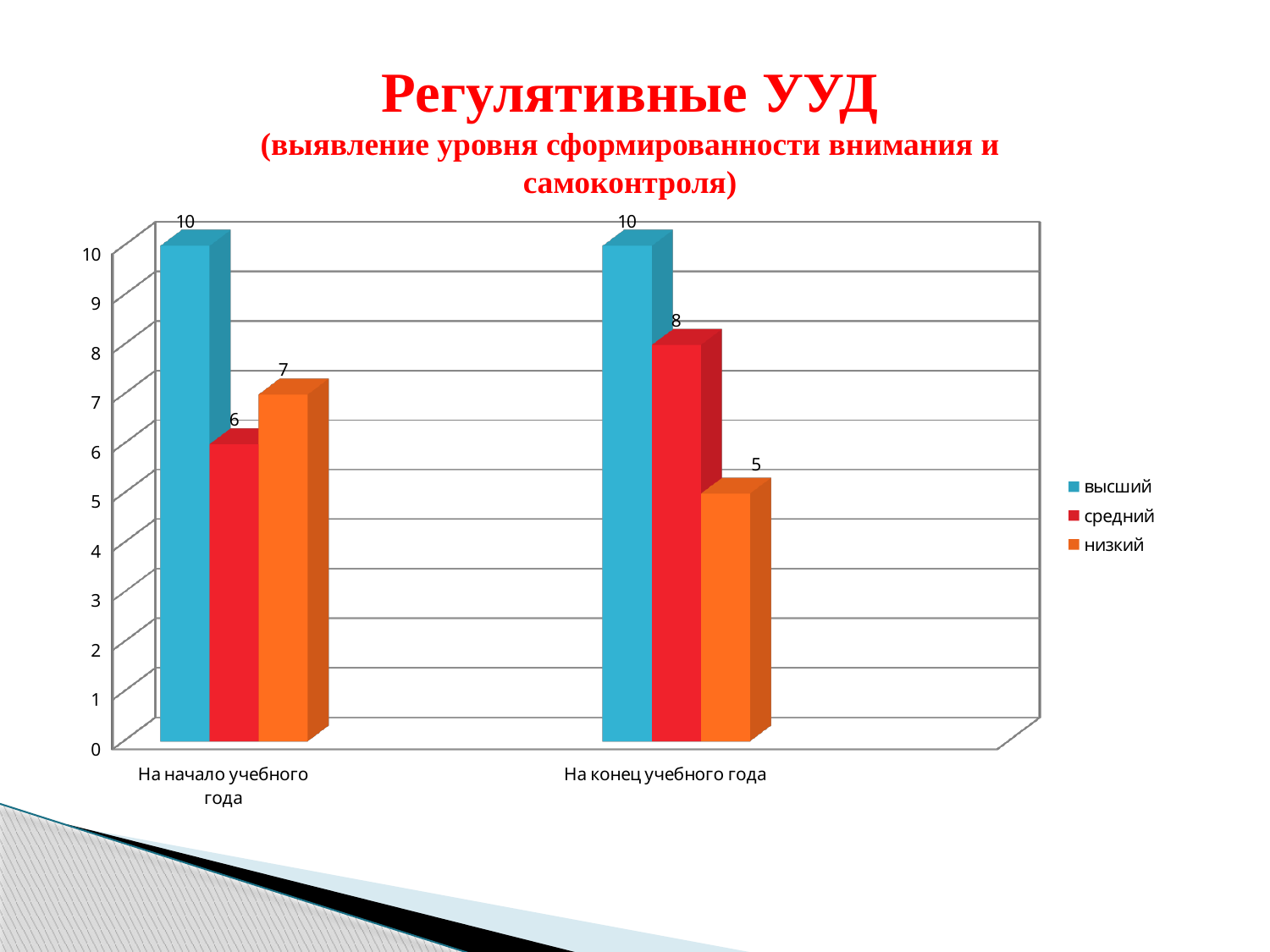
Which series has the highest value at "На начало учебного года"? высший What is the value for "средний" at "На начало учебного года"? 6 What kind of chart is shown on the slide? bar chart Which series has the lowest value at "На конец учебного года"? низкий What is the value for "низкий" at "На конец учебного года"? 5 How many series does the legend list? 3 Which is larger: "низкий" at "На начало учебного года" or "низкий" at "На конец учебного года"? На начало учебного года How many categories are shown on the x axis? 2 What is the value for "высший" at "На начало учебного года"? 10 Does the "низкий" series rise or fall from "На начало учебного года" to "На конец учебного года"? fall What is the difference between the "средний" values at "На конец учебного года" and "На начало учебного года"? 2 What is the value for "средний" at "На конец учебного года"? 8